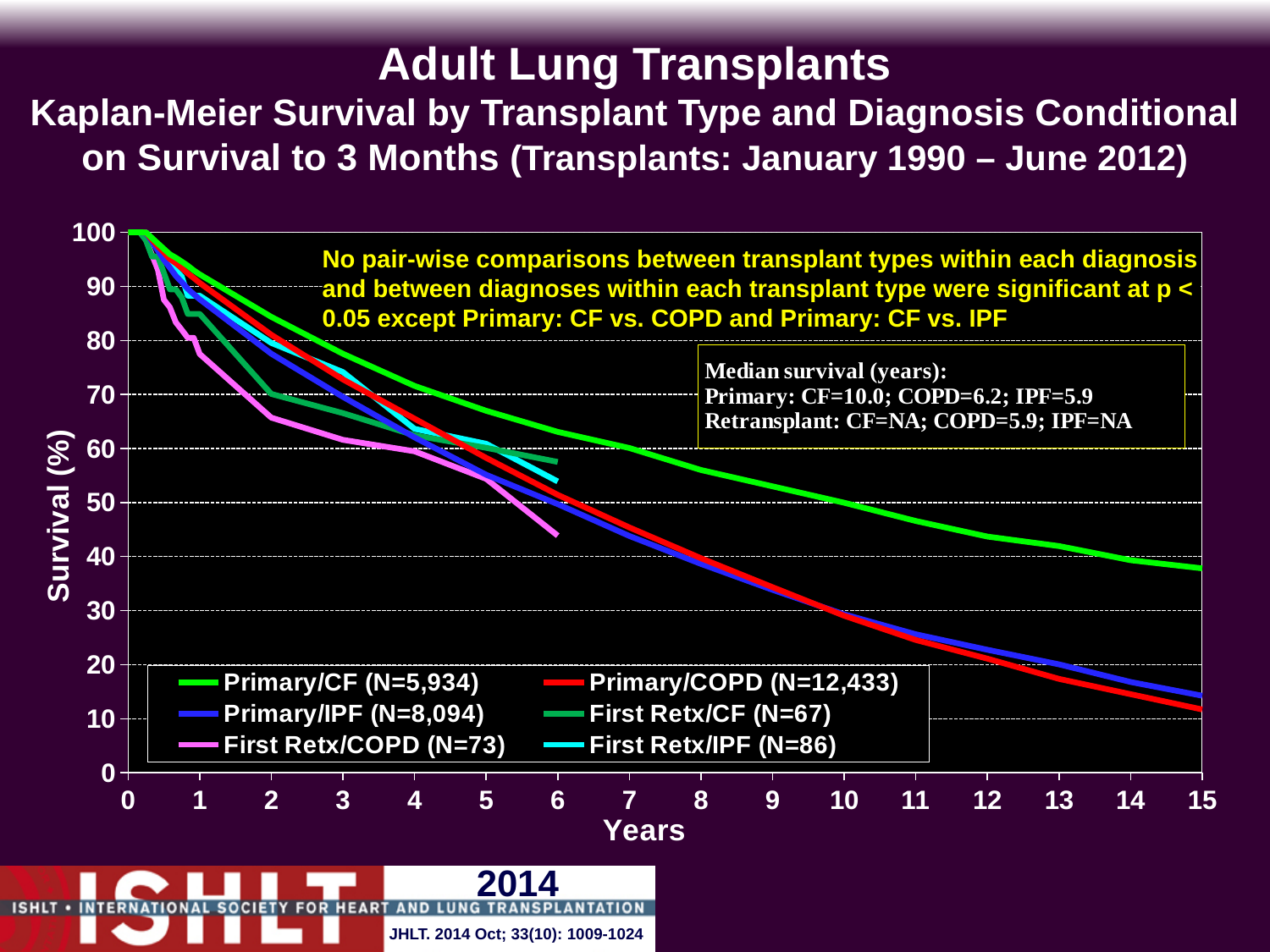
Which series has the highest survival at 15 years? Primary/CF At 15 years, which has higher survival: Primary/IPF or Primary/COPD? Primary/IPF Which series has the lowest survival at 15 years? Primary/COPD At 2 years, which has higher survival: Primary/CF or First Retx/COPD? Primary/CF What is the N shown in the legend for Primary/COPD? 12,433 Is the survival for Primary/COPD at 15 years greater or less than 20? less Is the survival for Primary/CF at 10 years greater or less than 40? greater How many series does the legend list? 6 Is the survival for Primary/CF at 15 years greater or less than 30? greater Do the survival curves rise or fall as years increase? fall What kind of chart is shown on the slide? line chart